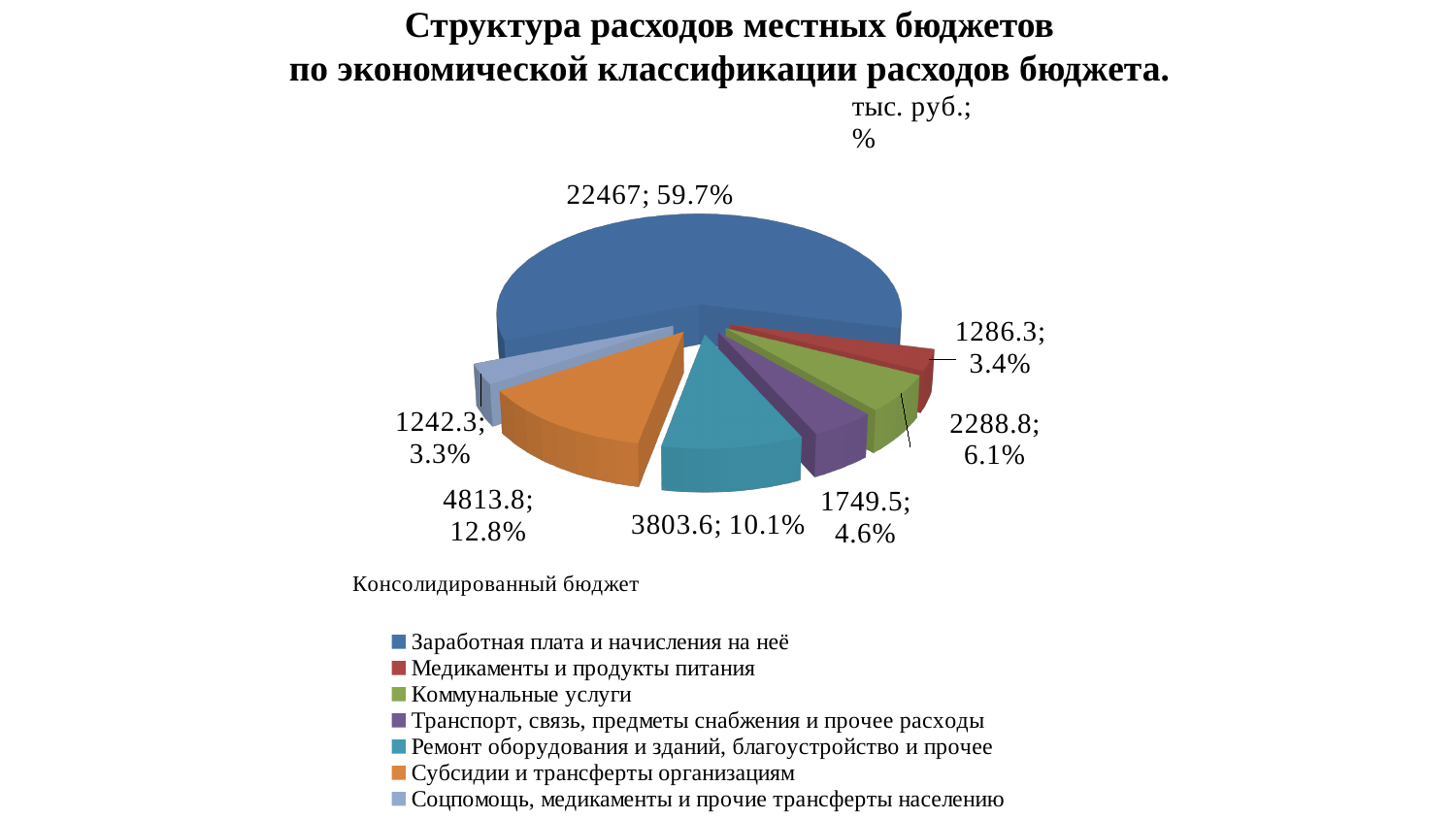
What is the difference between the values for "Субсидии и трансферты организациям" and "Ремонт оборудования и зданий, благоустройство и прочее"? 1010.2 Which category has the smallest share of the pie? Соцпомощь, медикаменты и прочие трансферты населению Which category has the largest share of the pie? Заработная плата и начисления на неё What percentage share does "Субсидии и трансферты организациям" have? 12.8% How many entries does the legend list? 7 What label appears directly below the pie chart? Консолидированный бюджет What percentage share does "Коммунальные услуги" have? 6.1% How many slices does the pie chart have? 7 Which is larger: the value for "Медикаменты и продукты питания" or for "Транспорт, связь, предметы снабжения и прочее расходы"? Транспорт, связь, предметы снабжения и прочее расходы What kind of chart is shown on the slide? Pie chart What value (in тыс. руб.) is shown for "Заработная плата и начисления на неё"? 22467 What value is shown for "Ремонт оборудования и зданий, благоустройство и прочее"? 3803.6